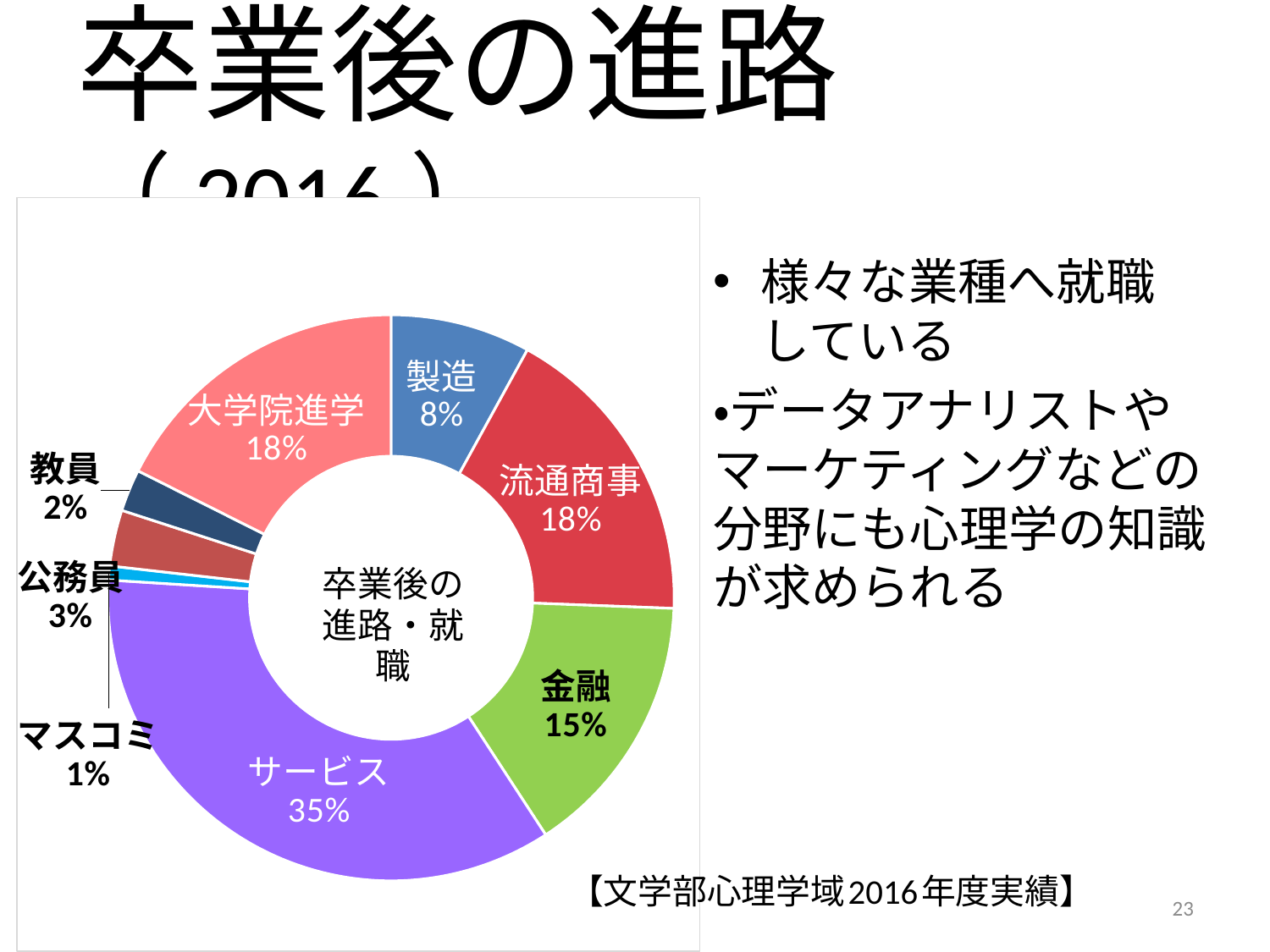
What percentage is shown for 金融? 15% What percentage is shown for 製造? 8% What kind of chart is shown on the slide? Pie (donut) chart Which category has the largest share of the chart? サービス Which category has the smallest share of the chart? マスコミ What share of the chart does サービス account for? 35% What percentage is shown for 大学院進学? 18% Which is larger, the share for 流通商事 or the share for 製造? 流通商事 What text is written in the center of the donut chart? 卒業後の進路・就職 What is the difference in percentage points between サービス and 金融? 20% What percentage is shown for 公務員? 3% How many categories are shown in the chart? 8